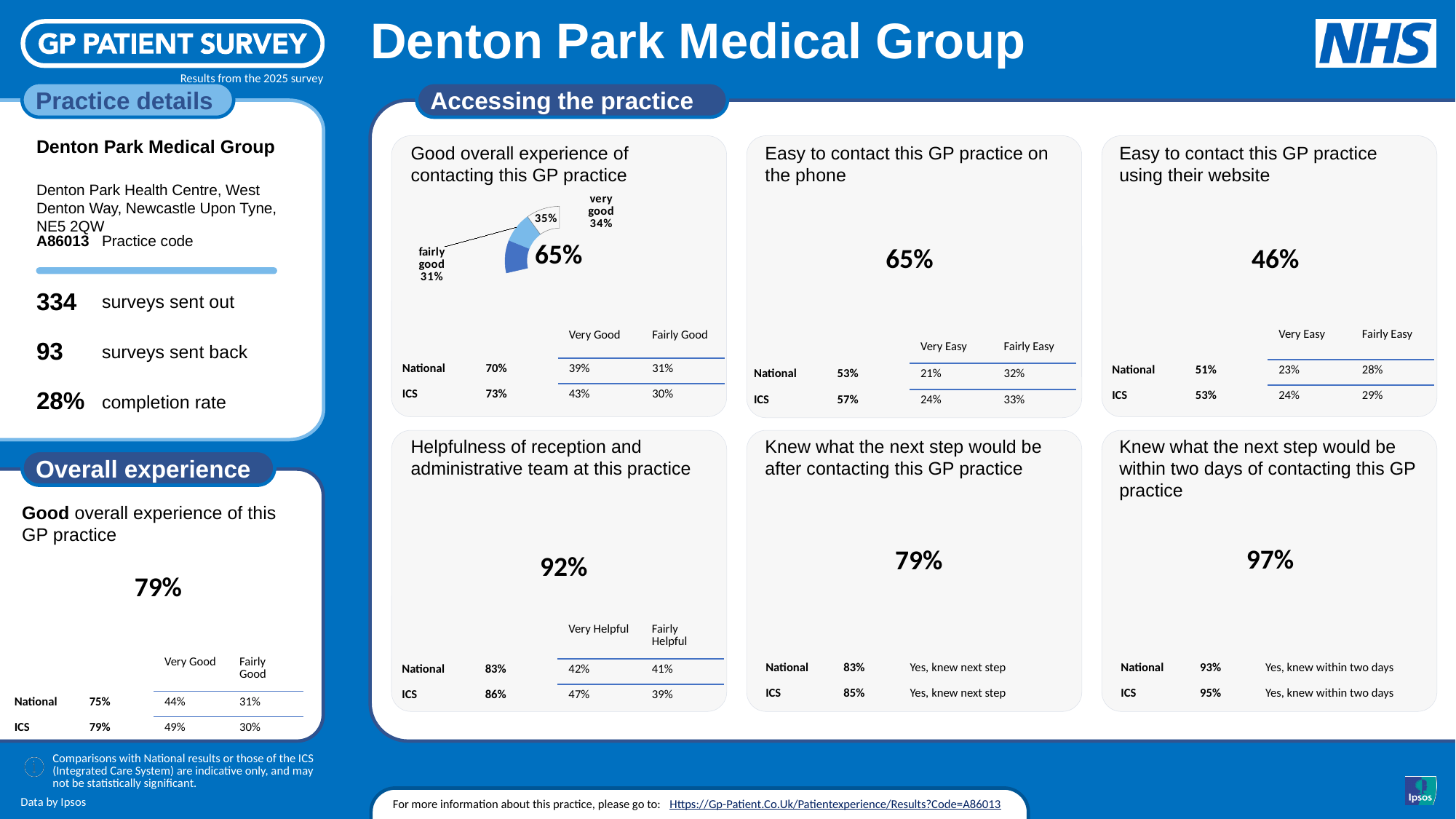
What is the large value printed in the centre of the 'Good overall experience of contacting this GP practice' chart? 65% Below the 'Good overall experience of contacting this GP practice' chart, what is the ICS overall figure? 73% In the 'Good overall experience of contacting this GP practice' chart, which is larger: 'very good' or 'fairly good'? very good In the 'Good overall experience of contacting this GP practice' chart, what is the difference between the 'very good' and 'fairly good' percentages? 3% In the 'Good overall experience of contacting this GP practice' chart, what percentage is labelled 'very good'? 34% What kind of chart is shown under 'Good overall experience of contacting this GP practice'? doughnut chart Below the 'Good overall experience of contacting this GP practice' chart, what is the National 'Very Good' figure? 39% In the 'Good overall experience of contacting this GP practice' chart, what percentage is labelled 'fairly good'? 31% Below the 'Good overall experience of contacting this GP practice' chart, what is the National overall figure? 70% In the 'Good overall experience of contacting this GP practice' chart, what do the 'very good' and 'fairly good' segments add up to? 65% How many named segments ('very good', 'fairly good') are labelled in the 'Good overall experience of contacting this GP practice' chart? 2 What is the title of the panel containing the doughnut chart on this slide? Good overall experience of contacting this GP practice